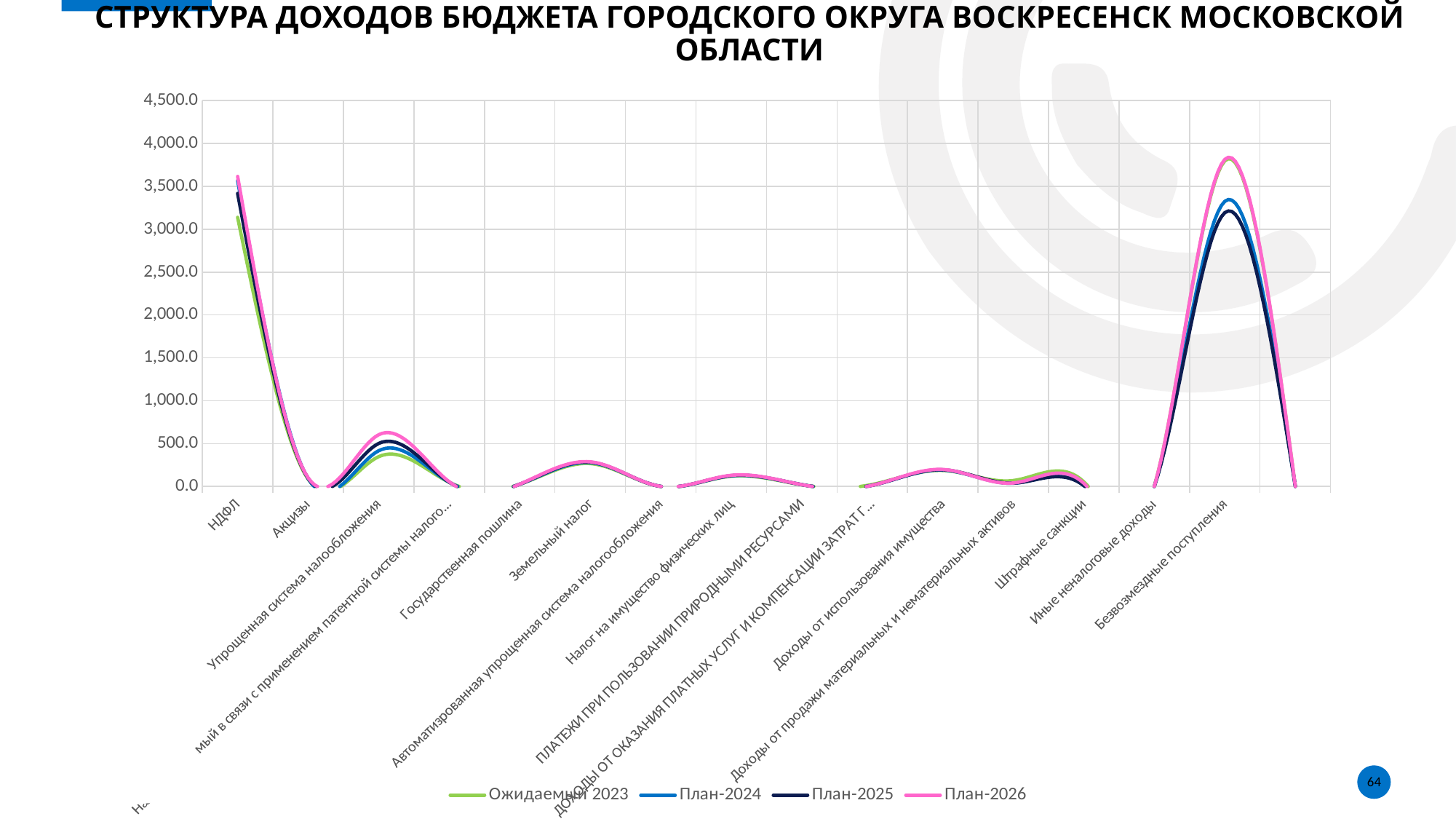
What kind of chart is shown on the slide? line chart How many series does the legend list? 4 For the series План-2026, which category has the highest value? Безвозмездные поступления What colour is the line for План-2026 in the legend? pink How many categories are shown along the x axis? 15 Is the value of План-2025 for Безвозмездные поступления greater or less than 3,500.0? less Is the value of План-2026 for НДФЛ greater or less than 3,000.0? greater Is the value of План-2026 for Безвозмездные поступления greater or less than 3,500.0? greater For Безвозмездные поступления, which is larger: План-2026 or План-2025? План-2026 For НДФЛ, which is larger: План-2026 or Ожидаемый 2023? План-2026